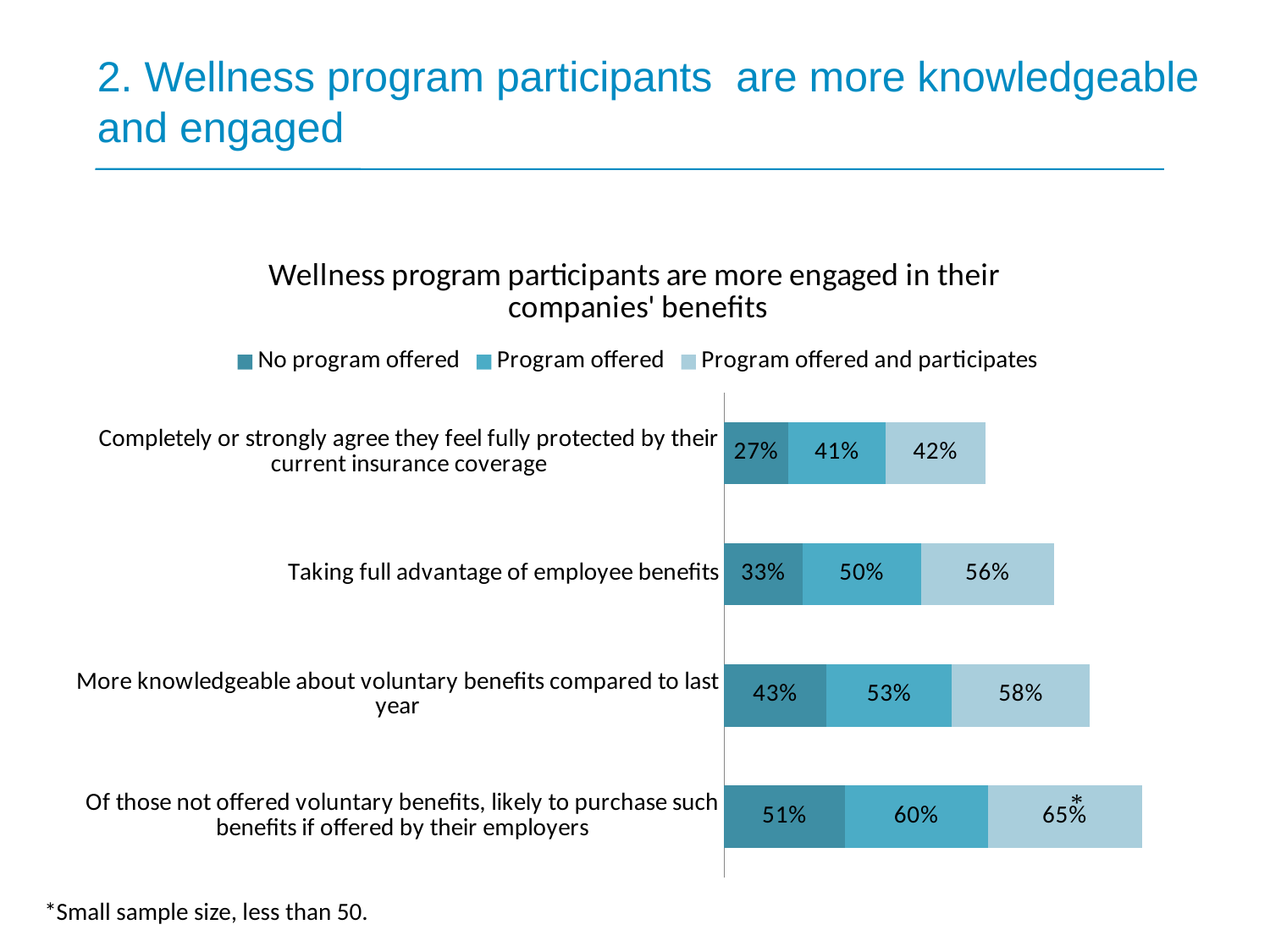
What is the value for "Program offered and participates" in the "More knowledgeable about voluntary benefits compared to last year" category? 58% For "More knowledgeable about voluntary benefits compared to last year", which is larger: "Program offered" or "No program offered"? Program offered What is the value for "No program offered" in the "Taking full advantage of employee benefits" category? 33% Which category has the highest value for "Program offered and participates"? Of those not offered voluntary benefits, likely to purchase such benefits if offered by their employers Which category has the lowest value for "No program offered"? Completely or strongly agree they feel fully protected by their current insurance coverage What is the title of the chart? Wellness program participants are more engaged in their companies' benefits What is the value for "Program offered" in the "Completely or strongly agree they feel fully protected by their current insurance coverage" category? 41% What is the value for "No program offered" in the "Of those not offered voluntary benefits, likely to purchase such benefits if offered by their employers" category? 51% How many categories are shown on the chart? 4 What is the difference between the "Program offered and participates" and "No program offered" values for "Taking full advantage of employee benefits"? 23% How many series does the legend list? 3 What kind of chart is shown on the slide? Bar chart